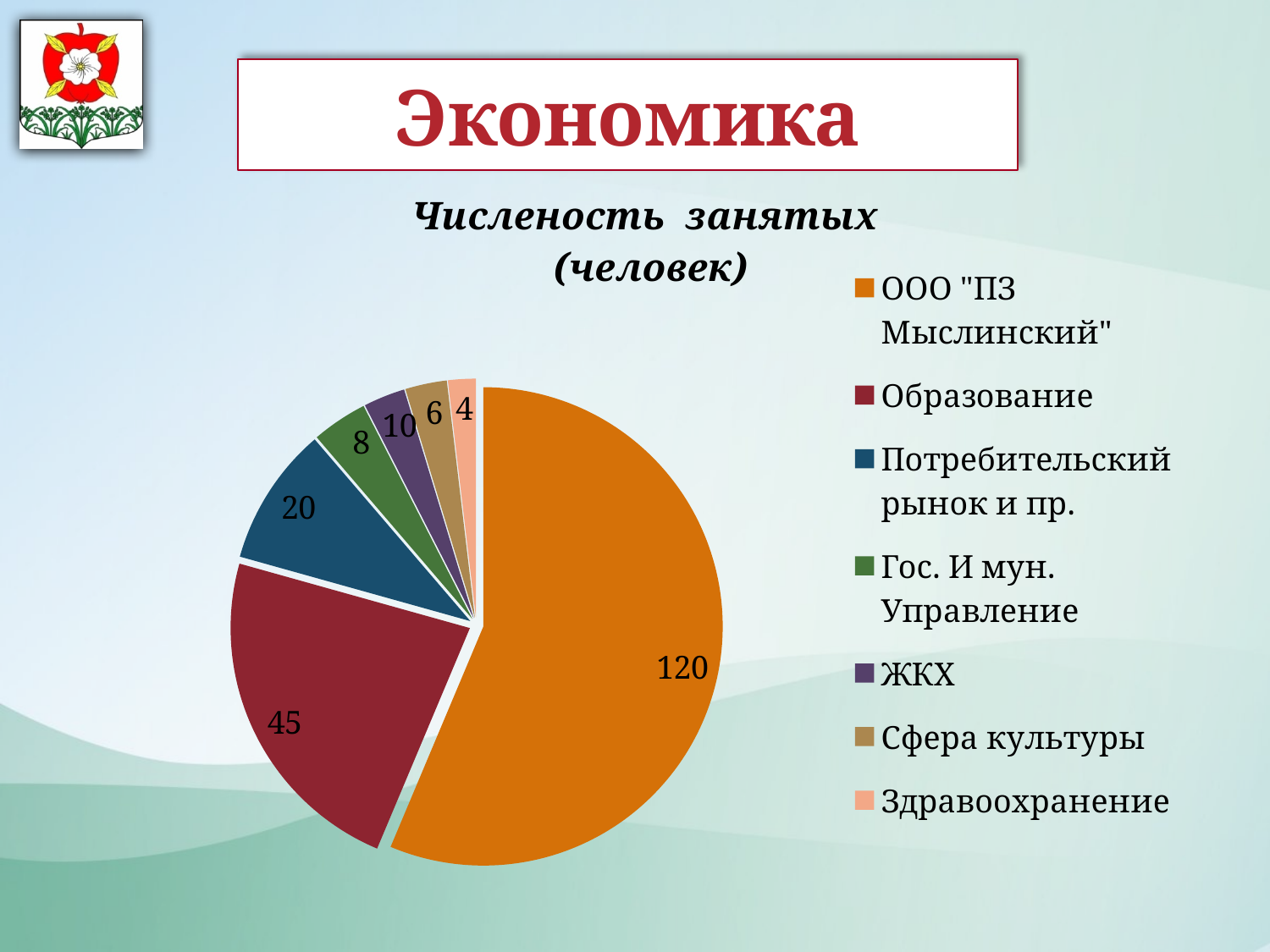
What is the value for ООО "ПЗ Мыслинский"? 120 Which category has the smallest slice? Здравоохранение Which category has the largest slice? ООО "ПЗ Мыслинский" What is the title of the chart? Численость занятых (человек) What is the value for ЖКХ? 10 What is the value for Потребительский рынок и пр.? 20 What is the value for Здравоохранение? 4 How many slices does the pie chart have? 7 What kind of chart is shown on the slide? pie chart What is the difference between the values for ООО "ПЗ Мыслинский" and Образование? 75 What is the value for Образование? 45 Which is larger, the value for ЖКХ or the value for Гос. И мун. Управление? ЖКХ